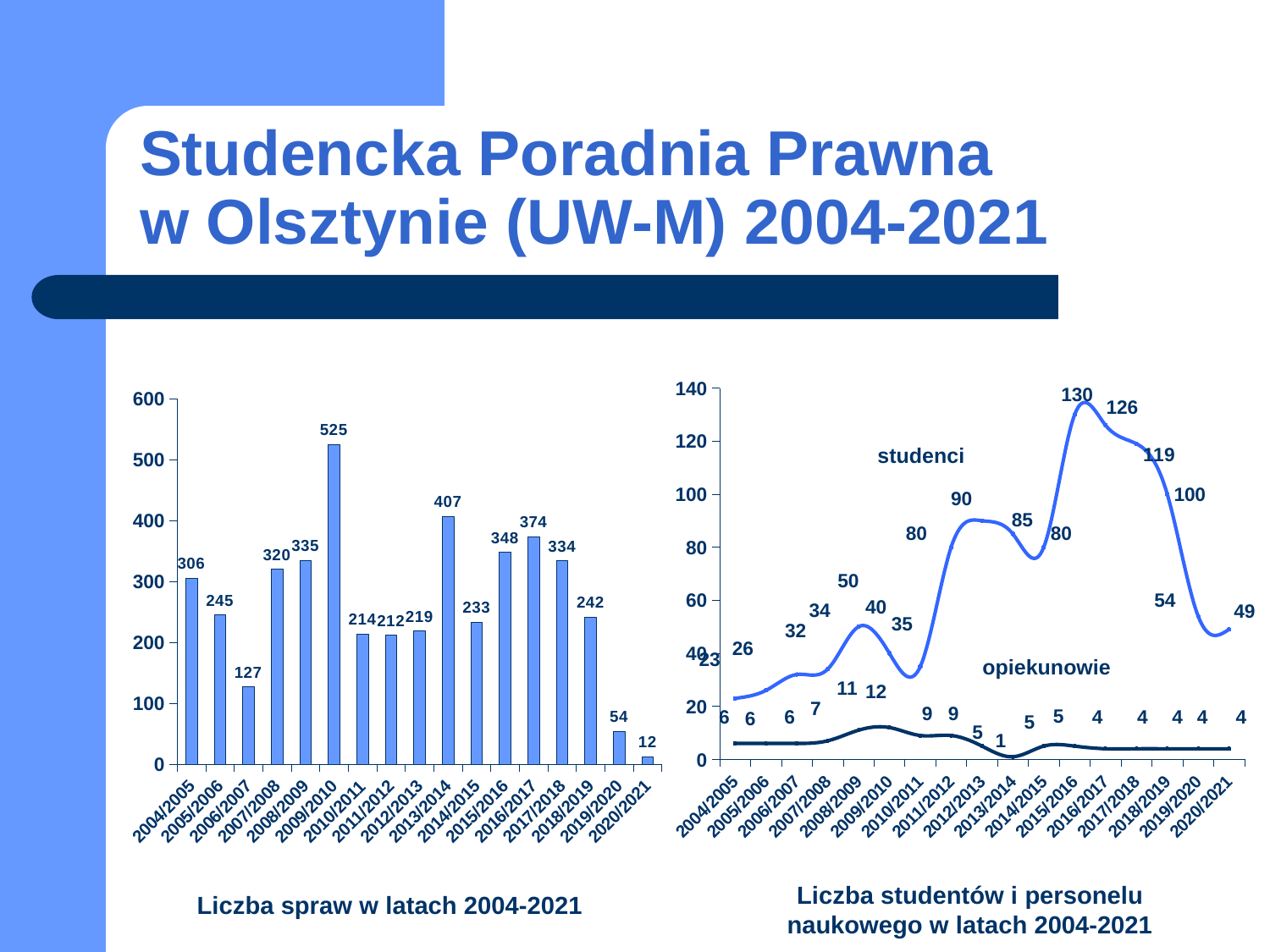
In the chart 'Liczba studentów i personelu naukowego w latach 2004-2021', which is larger in 2008/2009: studenci or opiekunowie? studenci In the chart 'Liczba studentów i personelu naukowego w latach 2004-2021', what is the difference between studenci in 2015/2016 and studenci in 2020/2021? 81 In the chart 'Liczba spraw w latach 2004-2021', what is the difference between the values for 2013/2014 and 2014/2015? 174 In the chart 'Liczba spraw w latach 2004-2021', how many years are shown on the x axis? 17 In the chart 'Liczba spraw w latach 2004-2021', which year has the highest value? 2009/2010 What kind of chart is 'Liczba spraw w latach 2004-2021'? bar chart In the chart 'Liczba spraw w latach 2004-2021', which year has the lowest value? 2020/2021 In the chart 'Liczba studentów i personelu naukowego w latach 2004-2021', what is the value for studenci in 2015/2016? 130 In the chart 'Liczba studentów i personelu naukowego w latach 2004-2021', how many series are plotted? 2 In the chart 'Liczba spraw w latach 2004-2021', what is the value for 2009/2010? 525 What kind of chart is 'Liczba studentów i personelu naukowego w latach 2004-2021'? line chart In the chart 'Liczba studentów i personelu naukowego w latach 2004-2021', what is the value for opiekunowie in 2013/2014? 1